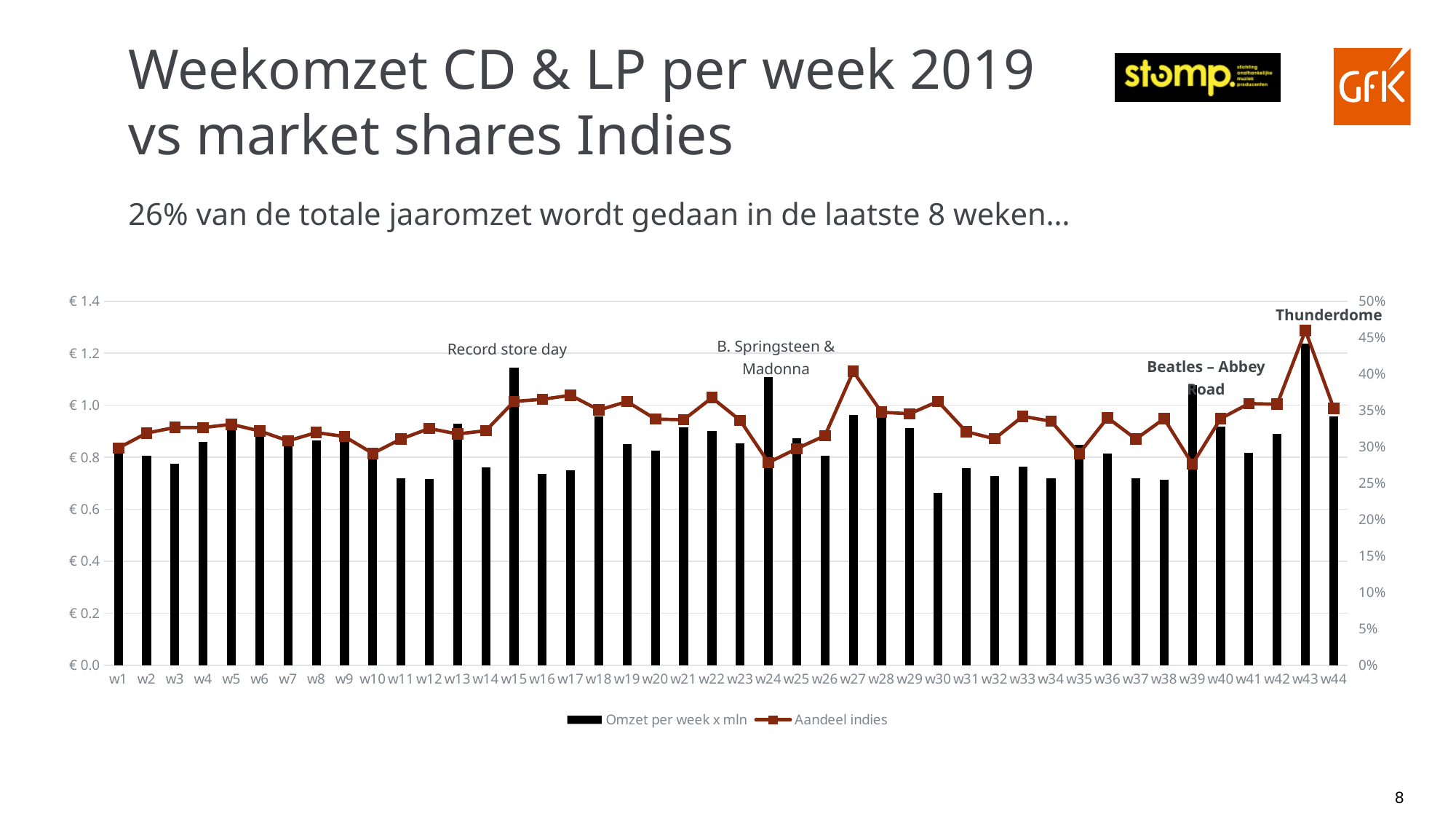
Which week has the larger 'Omzet per week x mln' bar, w43 or w15? w43 Which annotation is placed above the peak at w43? Thunderdome Which week has the lowest bar for 'Omzet per week x mln'? w30 Which week has the highest bar for 'Omzet per week x mln'? w43 Is the 'Aandeel indies' value for w39 greater or less than 30%? less How many series does the chart legend list? 2 Is the 'Omzet per week x mln' bar for w15 greater or less than € 1.0? greater How many weeks are plotted along the x axis of the chart? 44 In which week does the 'Aandeel indies' line reach its highest point? w43 Is the 'Omzet per week x mln' bar for w30 greater or less than € 0.8? less What kind of chart is shown on the slide? A combined bar chart and line chart